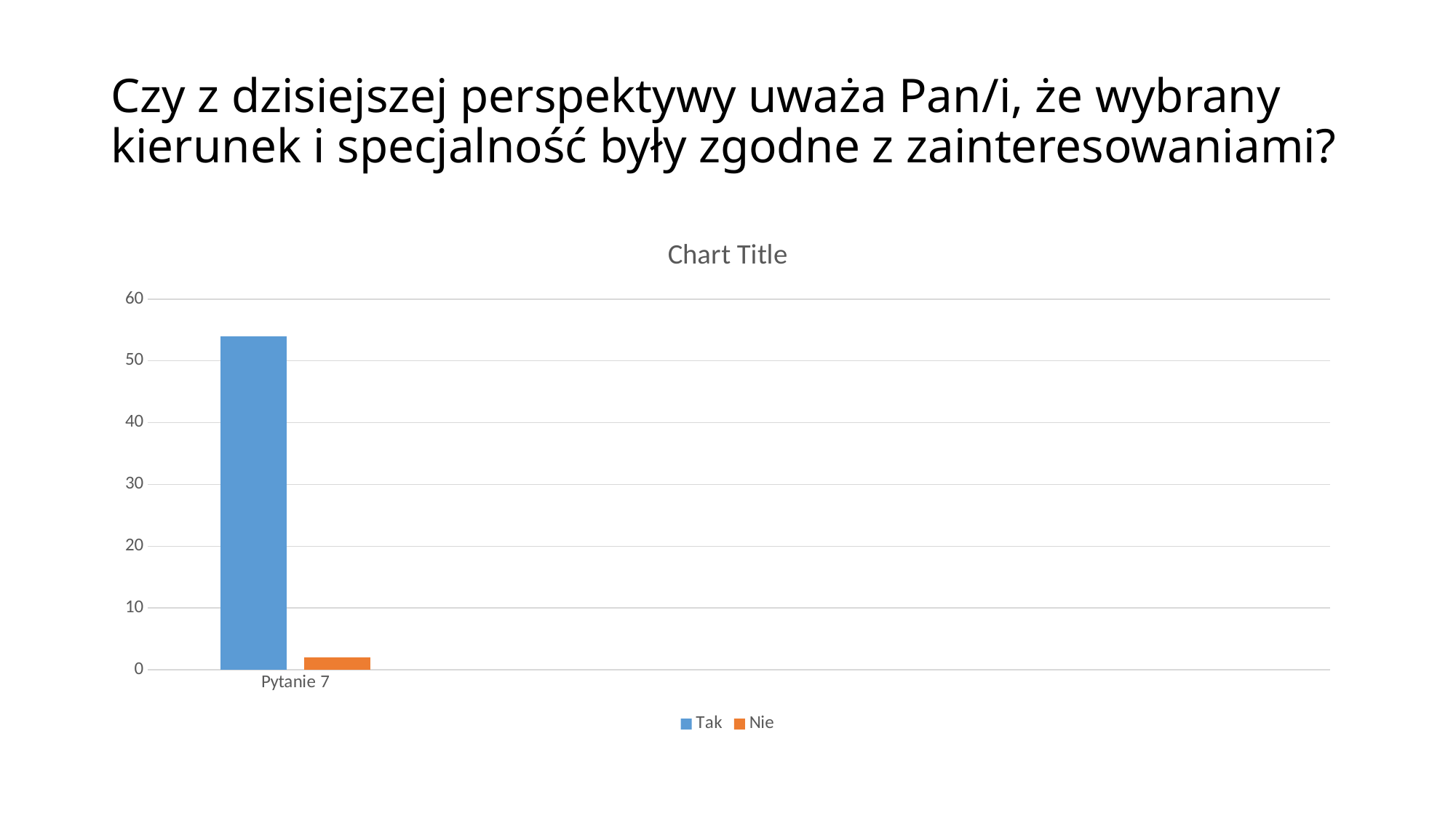
How many series does the legend list? 2 Is the value for Tak greater or less than 50? greater Which series has the higher value for Pytanie 7, Tak or Nie? Tak Which series has the lowest value for Pytanie 7? Nie Is the value for Nie greater or less than 10? less What colour is the bar for the Tak series? blue What is the label of the category on the x axis? Pytanie 7 How many categories are shown on the x axis? 1 Is the value for Tak greater or less than 60? less What kind of chart is shown on the slide? bar chart